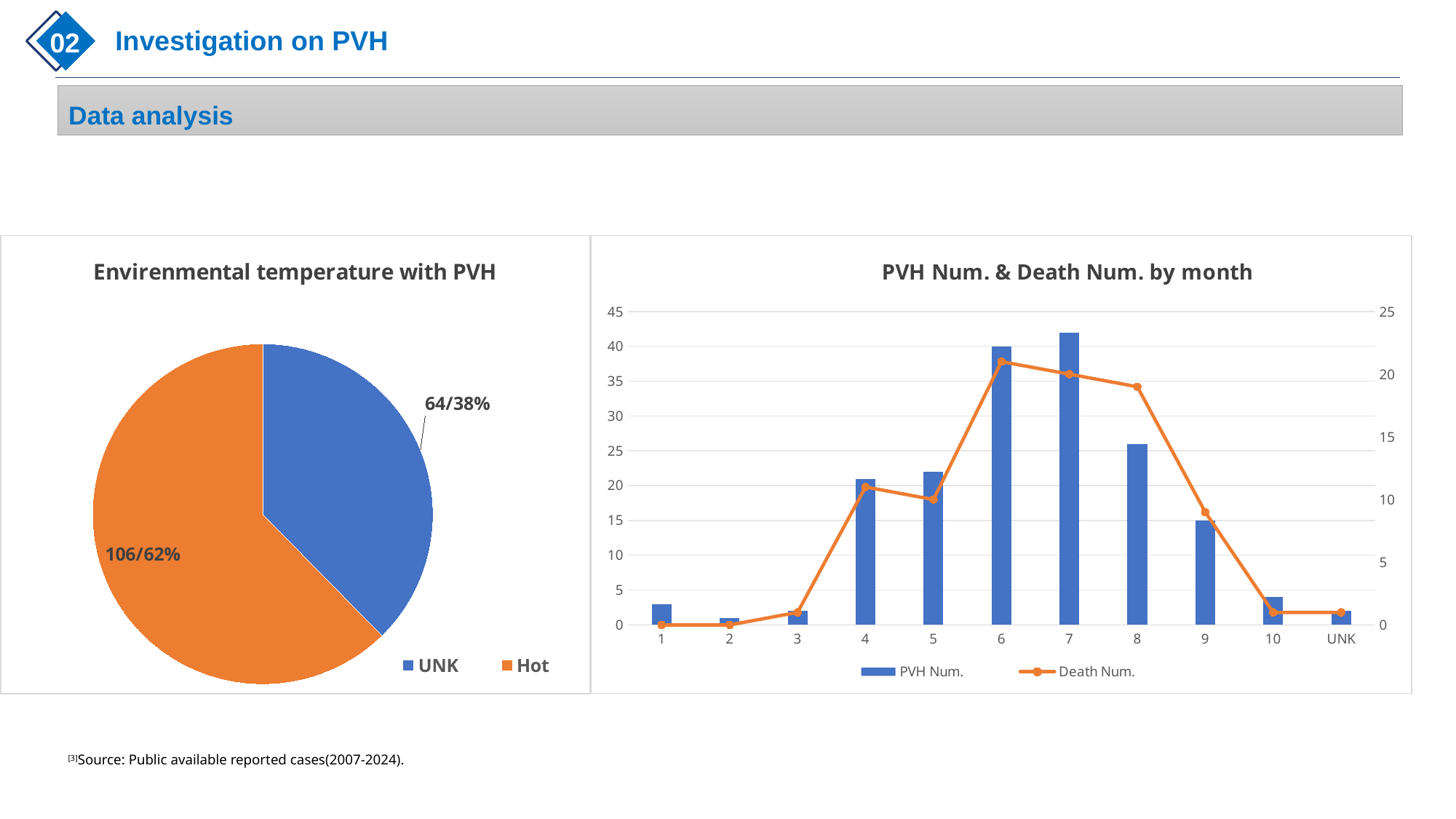
On the pie chart 'Envirenmental temperature with PVH', what is the data label shown for the Hot slice? 106/62% On the chart 'PVH Num. & Death Num. by month', which series is drawn as a line? Death Num. On the chart 'PVH Num. & Death Num. by month', is the PVH Num. value for month 9 greater or less than 20? less On the chart 'PVH Num. & Death Num. by month', how many series does the legend list? 2 On the chart 'PVH Num. & Death Num. by month', is the PVH Num. value for month 6 greater or less than 35? greater On the pie chart 'Envirenmental temperature with PVH', how many slices are there? 2 On the chart 'PVH Num. & Death Num. by month', which month has the highest PVH Num. bar? 7 On the pie chart 'Envirenmental temperature with PVH', what share of the pie does the UNK slice represent? 38% On the chart 'PVH Num. & Death Num. by month', how many categories are shown on the x axis? 11 On the pie chart 'Envirenmental temperature with PVH', what is the data label shown for the UNK slice? 64/38% On the pie chart 'Envirenmental temperature with PVH', which slice is larger, UNK or Hot? Hot On the pie chart 'Envirenmental temperature with PVH', what is the difference between the Hot count and the UNK count? 42